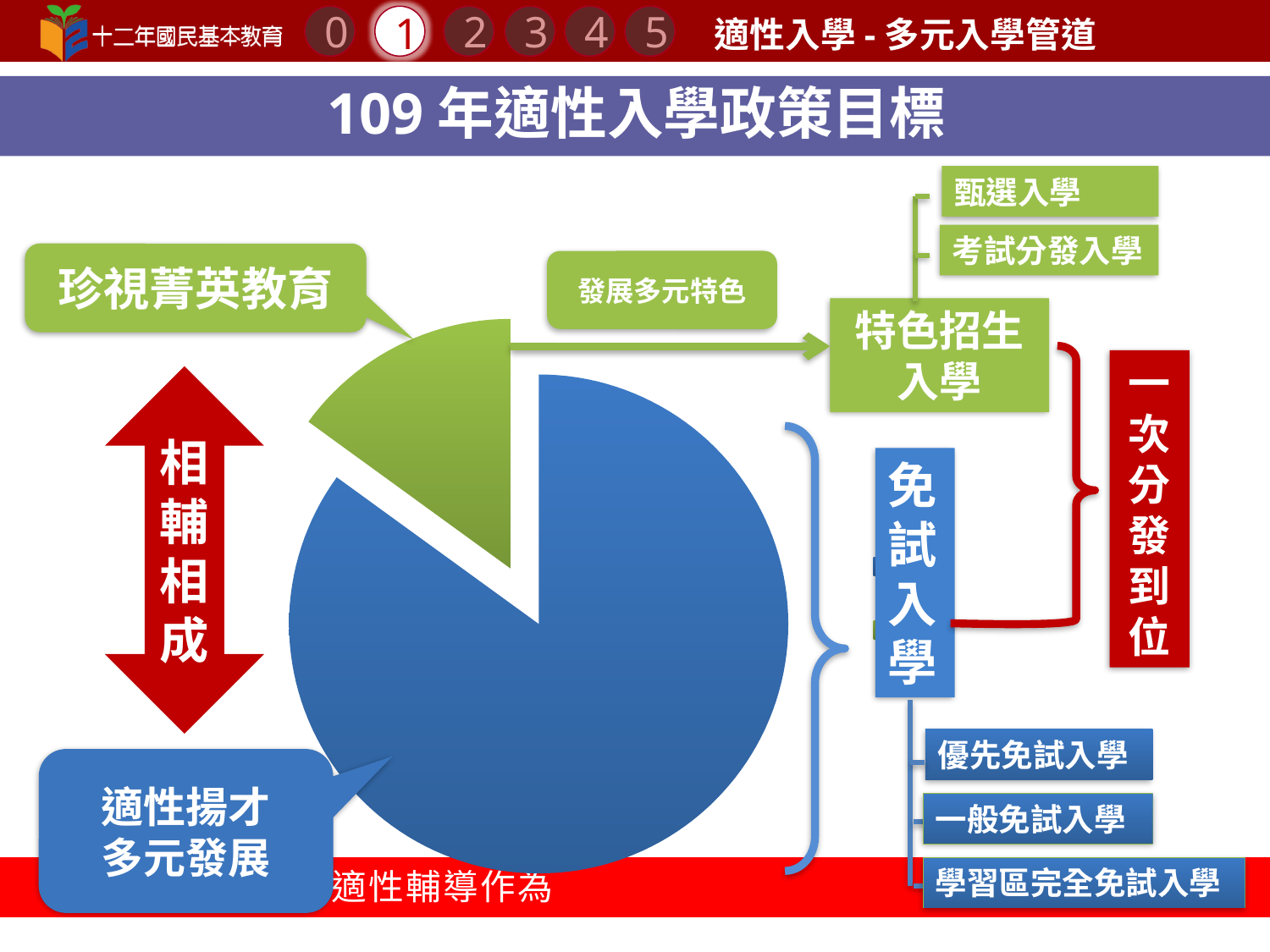
Which slice of the pie chart is larger, the blue one (免試入學) or the green one (特色招生入學)? the blue one (免試入學) Which admission route does the largest slice of the pie chart represent? 免試入學 What colour is the slice of the pie chart linked to 特色招生入學? green Which admission route does the smallest slice of the pie chart represent? 特色招生入學 How many slices does the pie chart have? 2 What kind of chart is shown in the centre of the slide? pie chart Which slice of the pie chart is pulled out (exploded) from the rest of the pie? the green slice (特色招生入學)